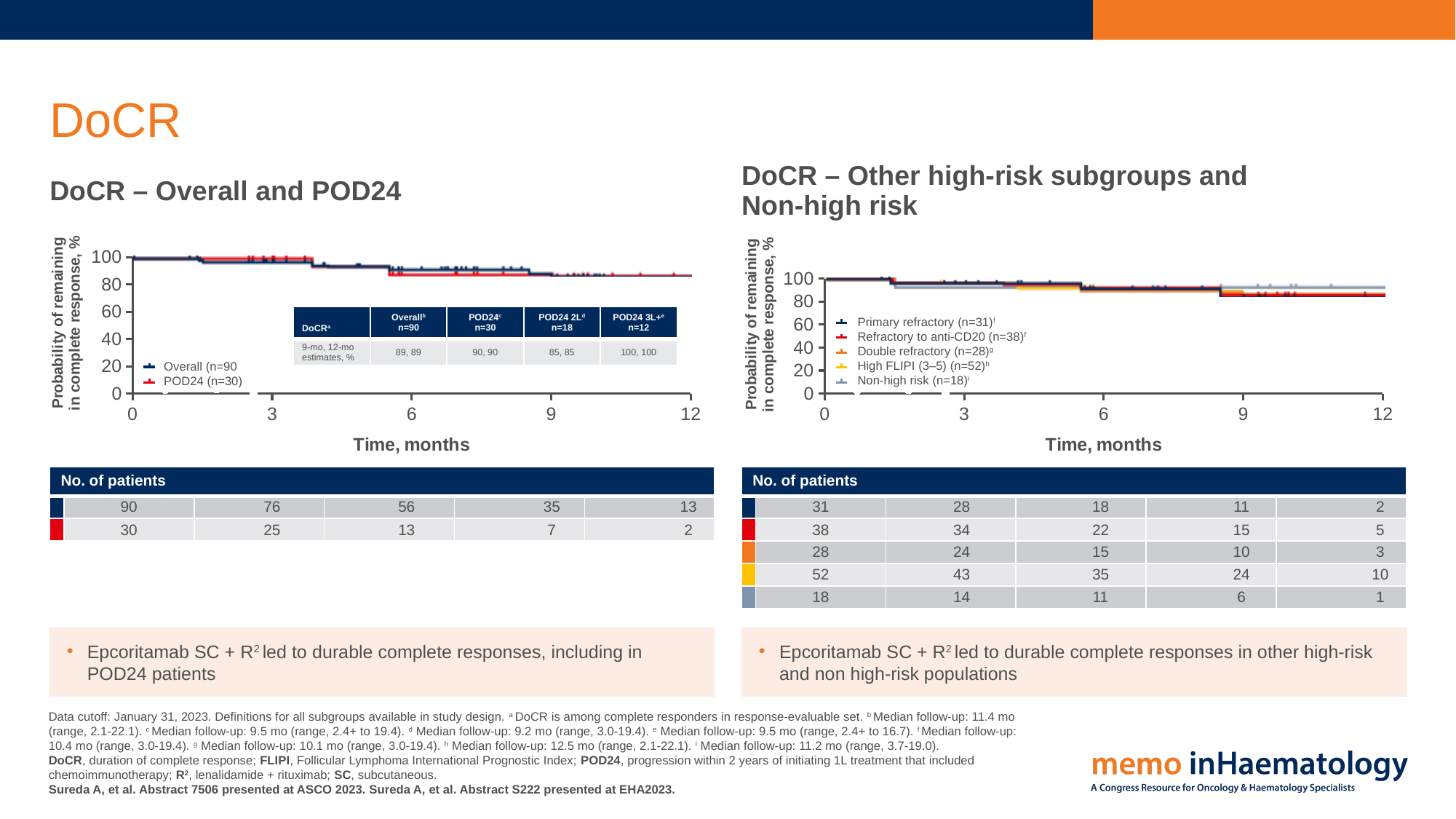
In the 'No. of patients' table under the chart 'DoCR – Other high-risk subgroups and Non-high risk', how many High FLIPI patients are at risk at 12 months? 10 What kind of chart is 'DoCR – Overall and POD24'? Line chart In the chart 'DoCR – Other high-risk subgroups and Non-high risk', how many series does the legend list? 5 What is the x-axis label of the chart 'DoCR – Overall and POD24'? Time, months In the chart 'DoCR – Overall and POD24', is the Overall curve at 12 months greater or less than 80? greater In the 'No. of patients' table under the chart 'DoCR – Overall and POD24', how many Overall patients are at risk at 6 months? 56 In the 'No. of patients' table under the chart 'DoCR – Overall and POD24', what is the difference between the Overall and POD24 numbers at 9 months? 28 In the chart 'DoCR – Other high-risk subgroups and Non-high risk', which subgroup has the largest number of patients at time 0? High FLIPI (3–5) (n=52) In the chart 'DoCR – Overall and POD24', do the curves rise or fall as time increases? Fall In the chart 'DoCR – Overall and POD24', how many series does the legend list? 2 In the table inside the chart 'DoCR – Overall and POD24', what is the 12-mo estimate for the Overall group? 89 In the table inside the chart 'DoCR – Overall and POD24', what are the 9-mo and 12-mo estimates for POD24 3L+? 100, 100